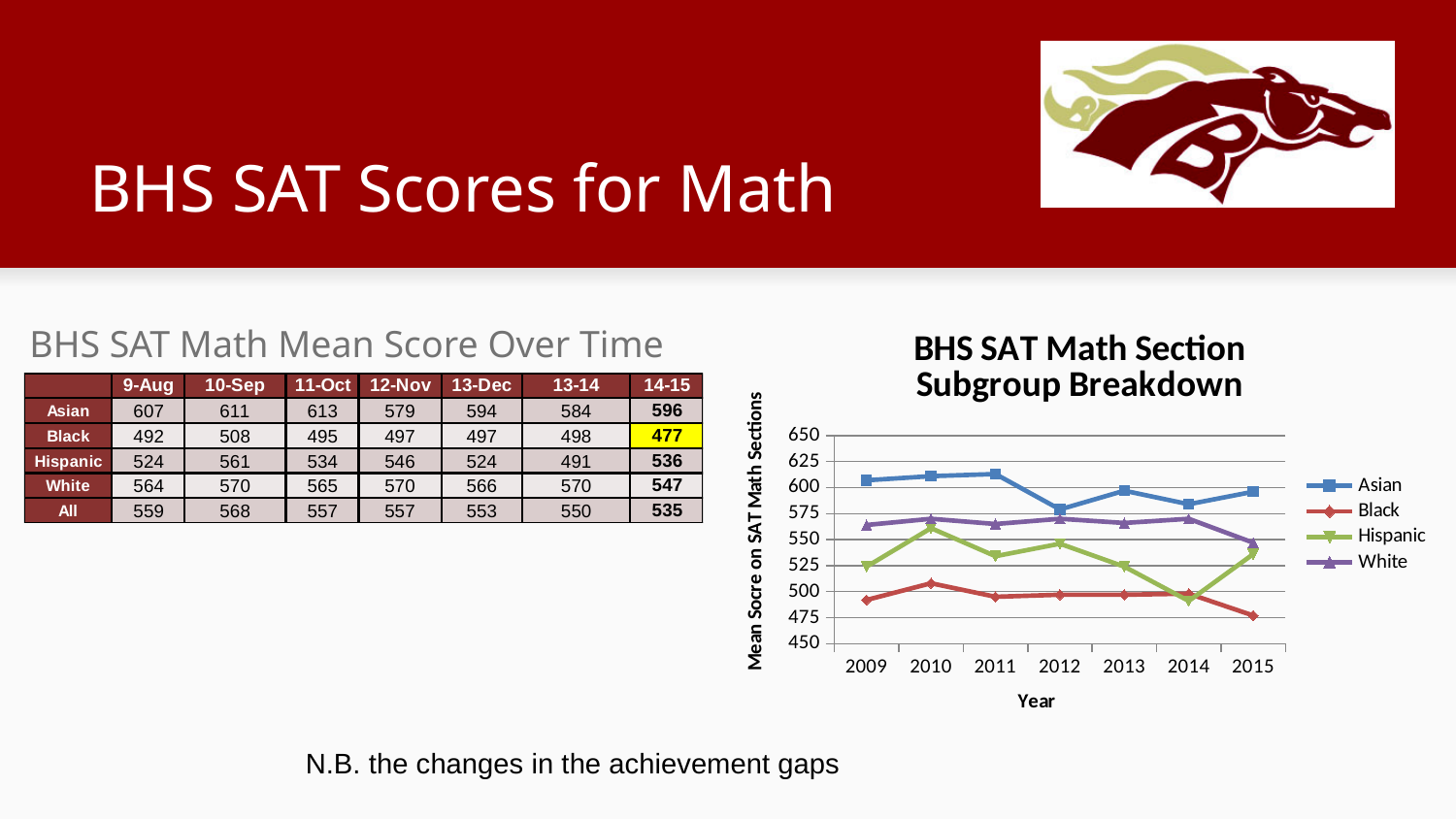
How many series does the legend of the BHS SAT Math Section Subgroup Breakdown chart list? 4 In the BHS SAT Math Section Subgroup Breakdown chart, is the Black value for 2015 greater or less than 500? less In the BHS SAT Math Section Subgroup Breakdown chart, which subgroup has the lowest score in 2015? Black In the BHS SAT Math Section Subgroup Breakdown chart, which is larger in 2014, the Hispanic value or the White value? White What kind of chart is the BHS SAT Math Section Subgroup Breakdown chart? line chart In the BHS SAT Math Section Subgroup Breakdown chart, does the Asian line rise or fall from 2011 to 2012? fall What is the x-axis title of the BHS SAT Math Section Subgroup Breakdown chart? Year In the BHS SAT Math Section Subgroup Breakdown chart, which subgroup has the highest score in 2009? Asian In the BHS SAT Math Section Subgroup Breakdown chart, is the Hispanic value for 2010 greater or less than 550? greater In the BHS SAT Math Section Subgroup Breakdown chart, does the Black line rise or fall from 2014 to 2015? fall In the BHS SAT Math Section Subgroup Breakdown chart, is the Asian value for 2009 greater or less than 600? greater How many years are shown on the x axis of the BHS SAT Math Section Subgroup Breakdown chart? 7